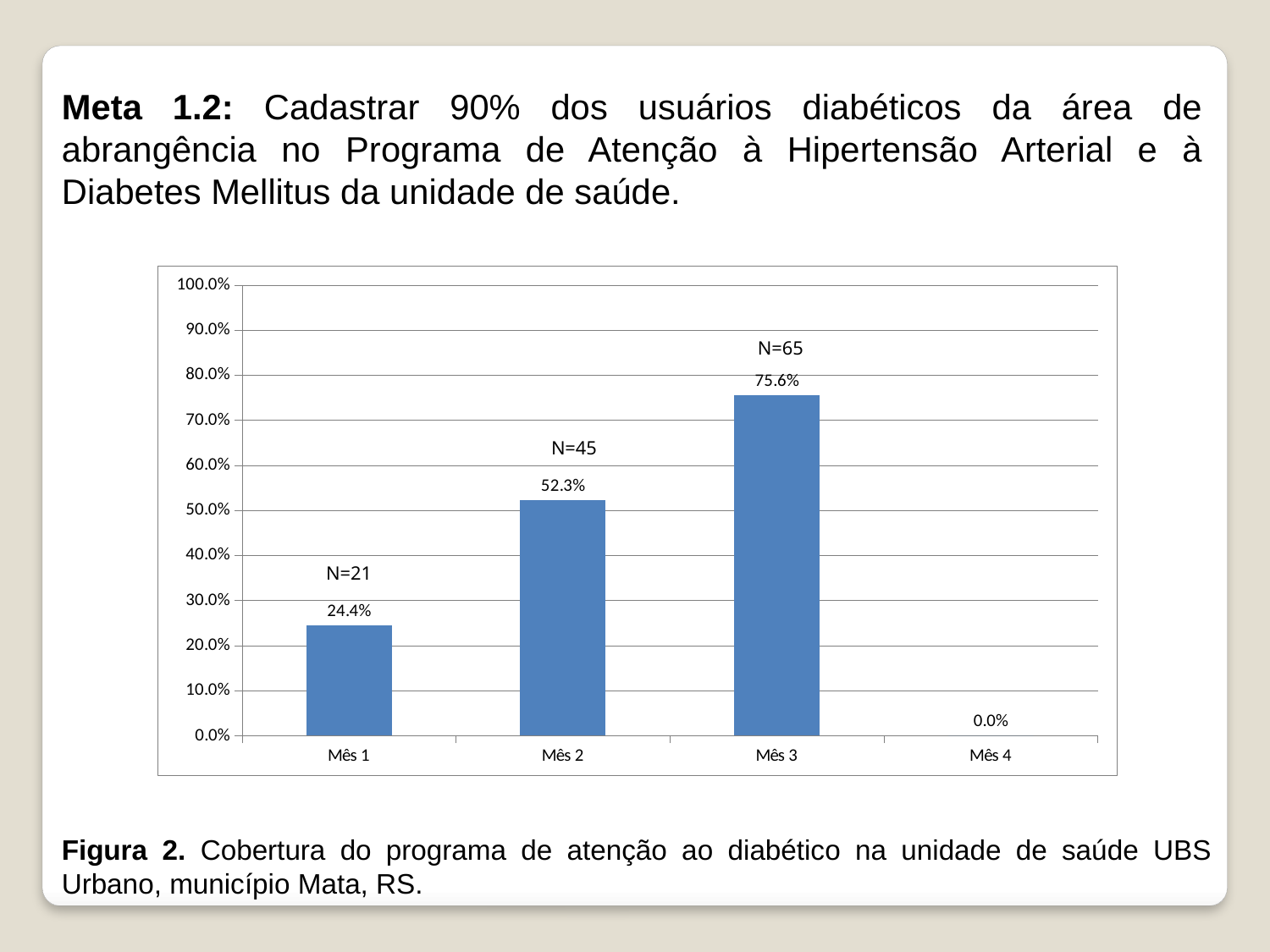
Which month has the lowest value? Mês 4 Is the value for Mês 3 greater or less than 70.0%? greater What is the value for Mês 4? 0.0% Which month has the highest value? Mês 3 What is the difference between the values for Mês 3 and Mês 2? 23.3% What is the value for Mês 3? 75.6% What N value is labelled above the bar for Mês 2? N=45 How many months are shown on the x axis? 4 Which is larger, the value for Mês 1 or the value for Mês 2? Mês 2 What is the value for Mês 2? 52.3% What kind of chart is shown? bar chart What is the value for Mês 1? 24.4%